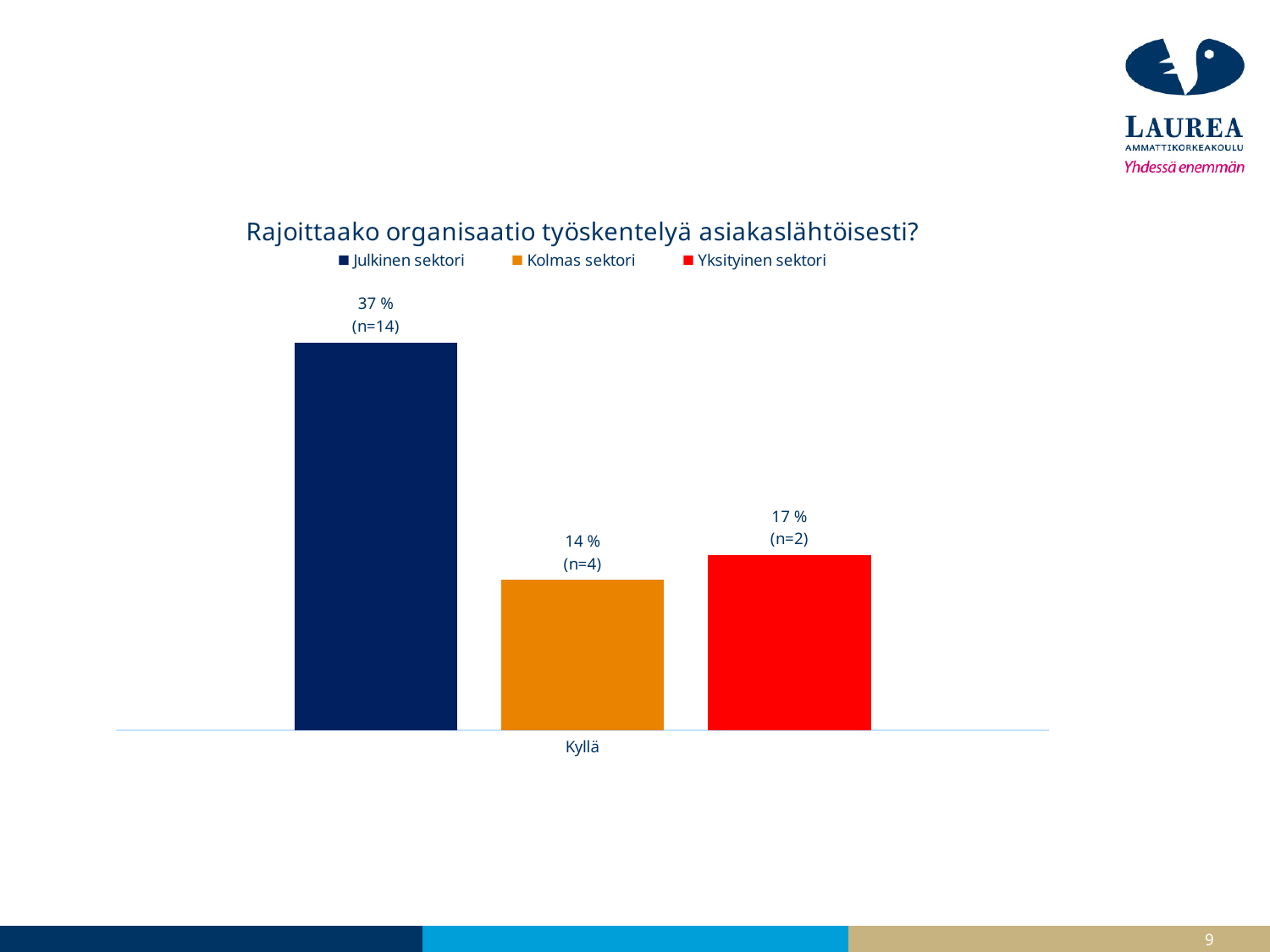
What is the value for Kolmas sektori? 14 % What is the title of the chart? Rajoittaako organisaatio työskentelyä asiakaslähtöisesti? Which series has the highest value? Julkinen sektori Which is larger, the value for Yksityinen sektori or Kolmas sektori? Yksityinen sektori What is the n value shown for Julkinen sektori? n=14 What is the difference between the values for Julkinen sektori and Kolmas sektori? 23 % Which series has the lowest value? Kolmas sektori What is the difference between the values for Yksityinen sektori and Kolmas sektori? 3 % What kind of chart is shown on the slide? Bar chart What is the value for Yksityinen sektori? 17 % What is the value for Julkinen sektori? 37 % How many series does the legend list? 3